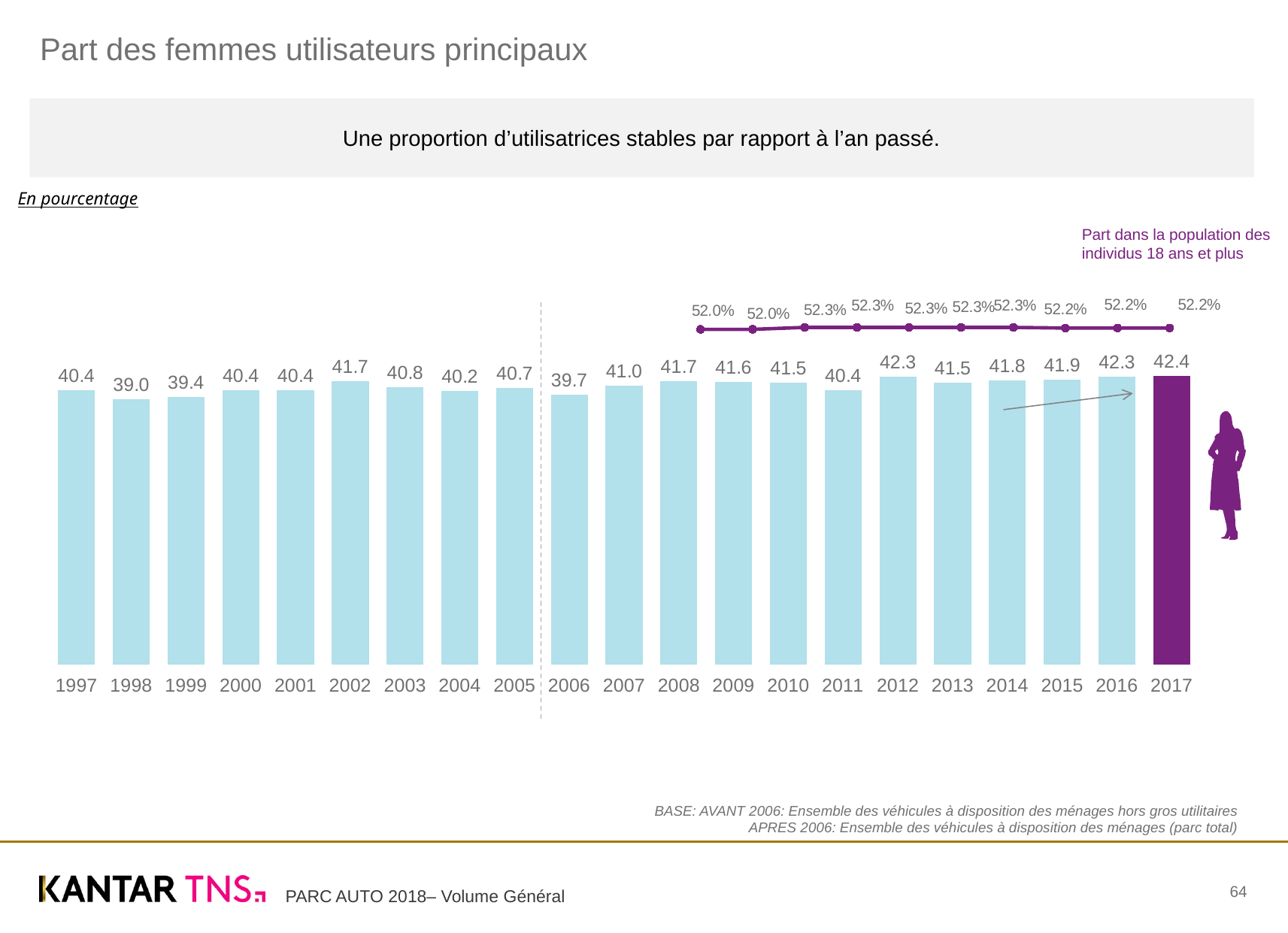
What is the value of the line series 'Part dans la population des individus 18 ans et plus' for 2008? 52.0% What kind of chart is used to show the share of women main users by year? bar chart How many years are shown on the x axis of the bar chart? 21 What is the value for 2011 in the bar chart? 40.4 Which year has the highest bar value? 2017 What is the value for 2017 in the bar chart? 42.4 Which year has the lowest bar value? 1998 What is the title of the slide's chart? Part des femmes utilisateurs principaux What is the value for 1998 in the bar chart? 39.0 Which year has the larger bar value, 2002 or 2003? 2002 What is the value of the line series 'Part dans la population des individus 18 ans et plus' for 2017? 52.2% What is the difference between the bar values for 2017 and 1997? 2.0